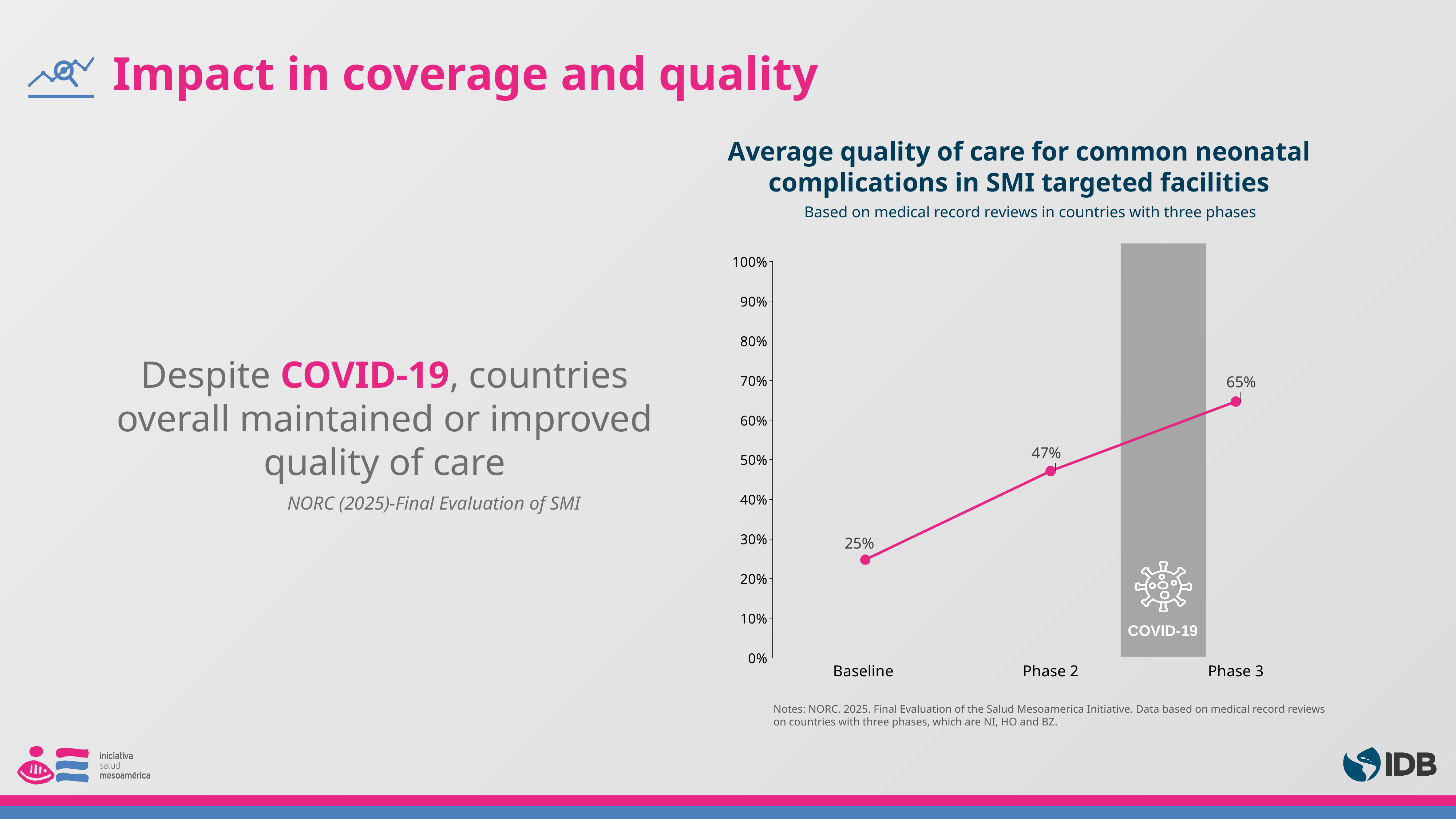
What is the average quality of care value at Phase 3? 65% What is the average quality of care value at Baseline? 25% What is the average quality of care value at Phase 2? 47% Which phase has the highest average quality of care? Phase 3 What is the difference in average quality of care between Phase 3 and Baseline? 40 percentage points How many data points are plotted on the chart? 3 Which phase has the lowest average quality of care? Baseline What is the difference in average quality of care between Phase 2 and Baseline? 22 percentage points Which is larger, the value at Phase 2 or the value at Phase 3? Phase 3 Do the values rise or fall from Baseline to Phase 3? Rise What kind of chart is shown on the slide? Line chart Is the value at Phase 2 greater or less than 50%? less